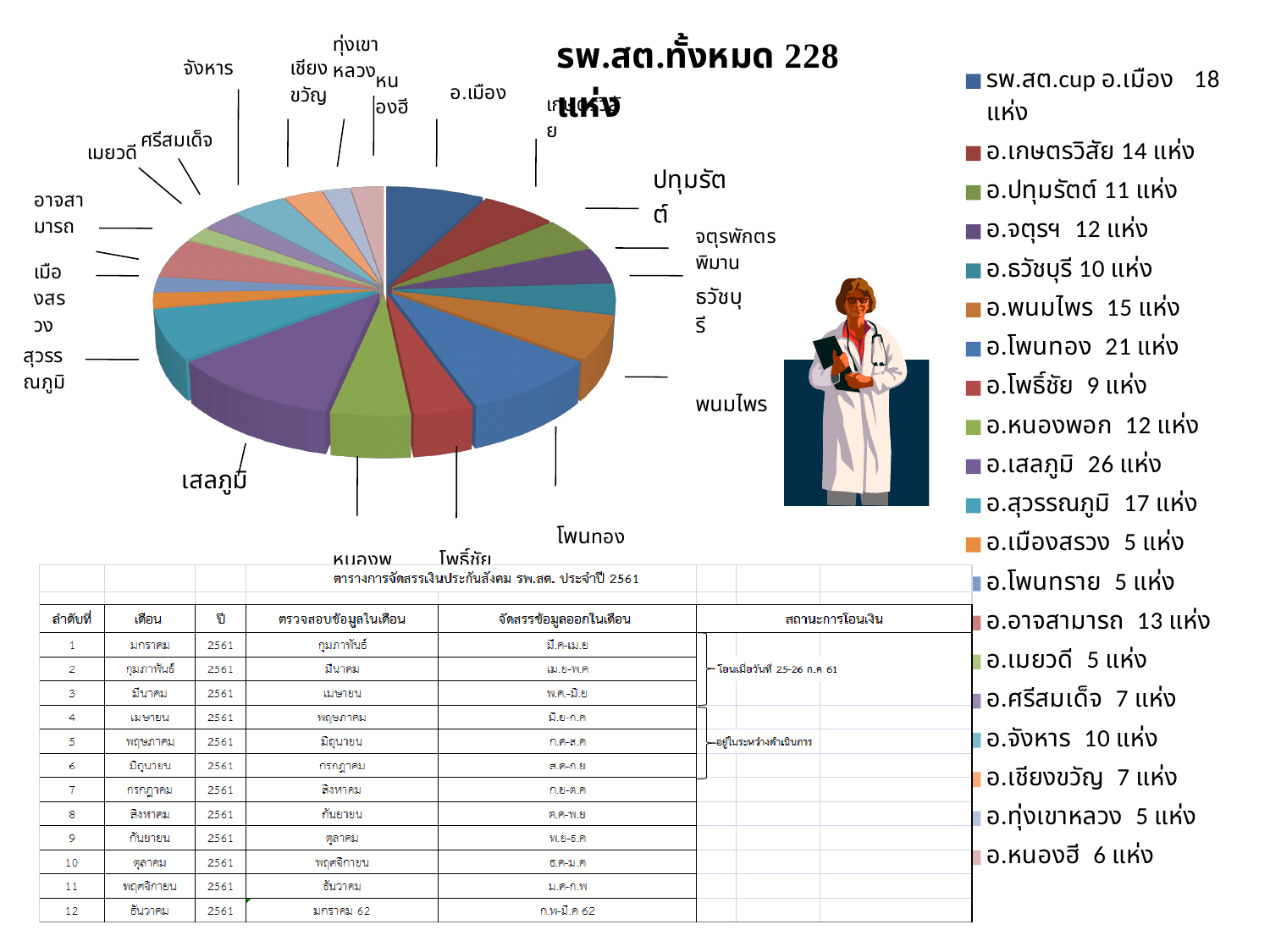
Which has more แห่ง, อ.พนมไพร or อ.เกษตรวิสัย? อ.พนมไพร What share of the total 228 แห่ง does อ.โพธิ์ชัย (9 แห่ง) represent, to the nearest whole percent? 4% According to the legend, how many แห่ง does อ.สุวรรณภูมิ have? 17 แห่ง What total number of รพ.สต. does the chart title state? 228 แห่ง How many categories does the pie chart's legend list? 20 Which category has the largest slice of the pie chart? อ.เสลภูมิ According to the legend, how many แห่ง does อ.โพนทอง have? 21 แห่ง What is the difference in แห่ง between อ.เสลภูมิ and อ.โพนทอง? 5 According to the legend, how many แห่ง does อ.อาจสามารถ have? 13 แห่ง According to the legend, how many แห่ง does อ.เสลภูมิ have? 26 แห่ง What type of chart is shown on the slide? pie chart What is the difference in แห่ง between รพ.สต.cup อ.เมือง and อ.หนองฮี? 12